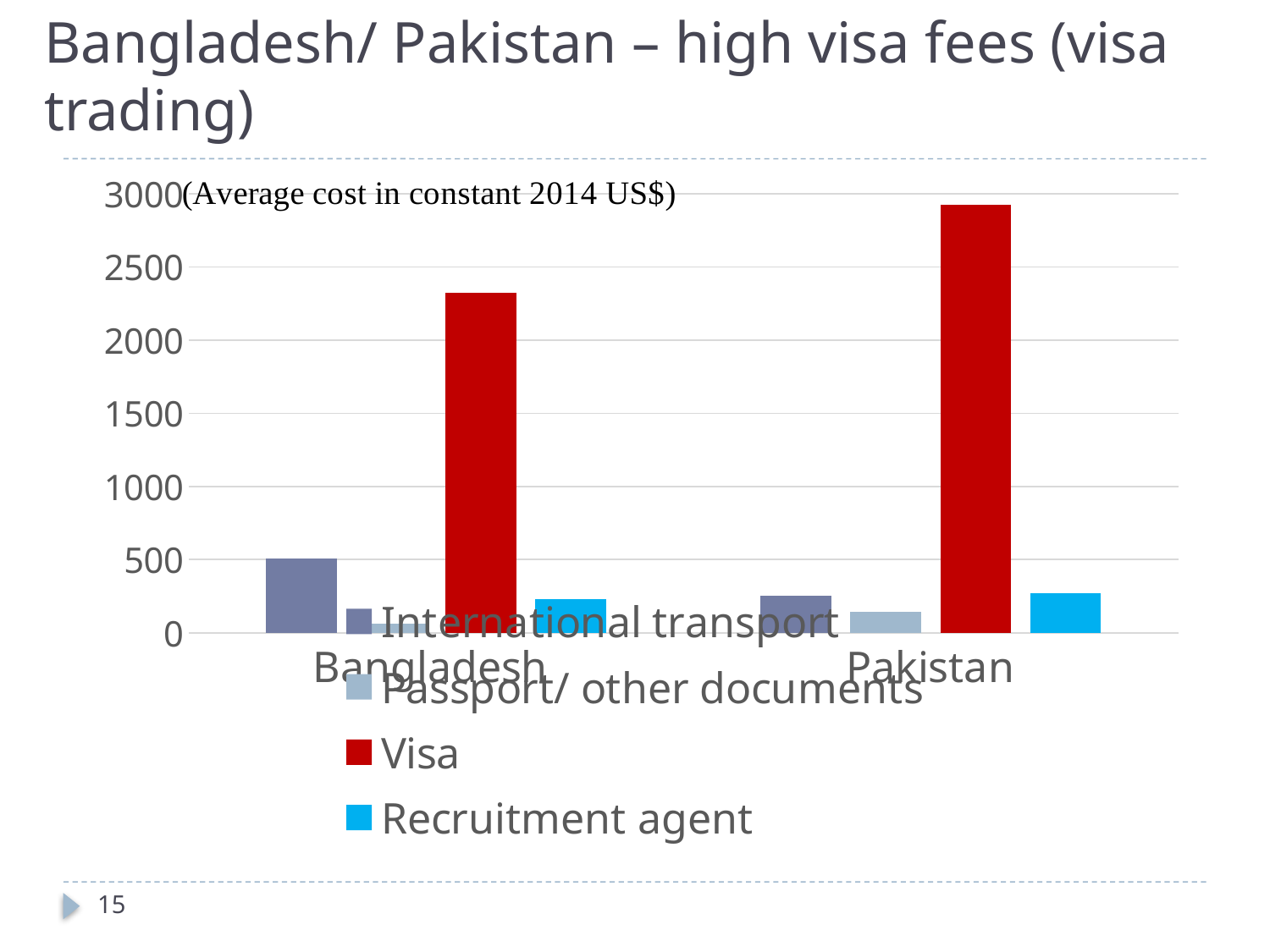
Which country has the larger Visa cost, Bangladesh or Pakistan? Pakistan What kind of chart is shown on the slide? bar chart Is the International transport cost for Pakistan greater or less than 500? less What colour represents the Visa series in the chart? red Which cost component is the lowest for Bangladesh? Passport/ other documents Which country has the larger International transport cost, Bangladesh or Pakistan? Bangladesh Is the Visa cost for Bangladesh greater or less than 2000? greater Is the Visa cost for Pakistan greater or less than 2500? greater Which cost component is the highest for Bangladesh? Visa Which cost component is the highest for Pakistan? Visa How many series does the chart legend list? 4 How many countries are shown on the x axis of the chart? 2